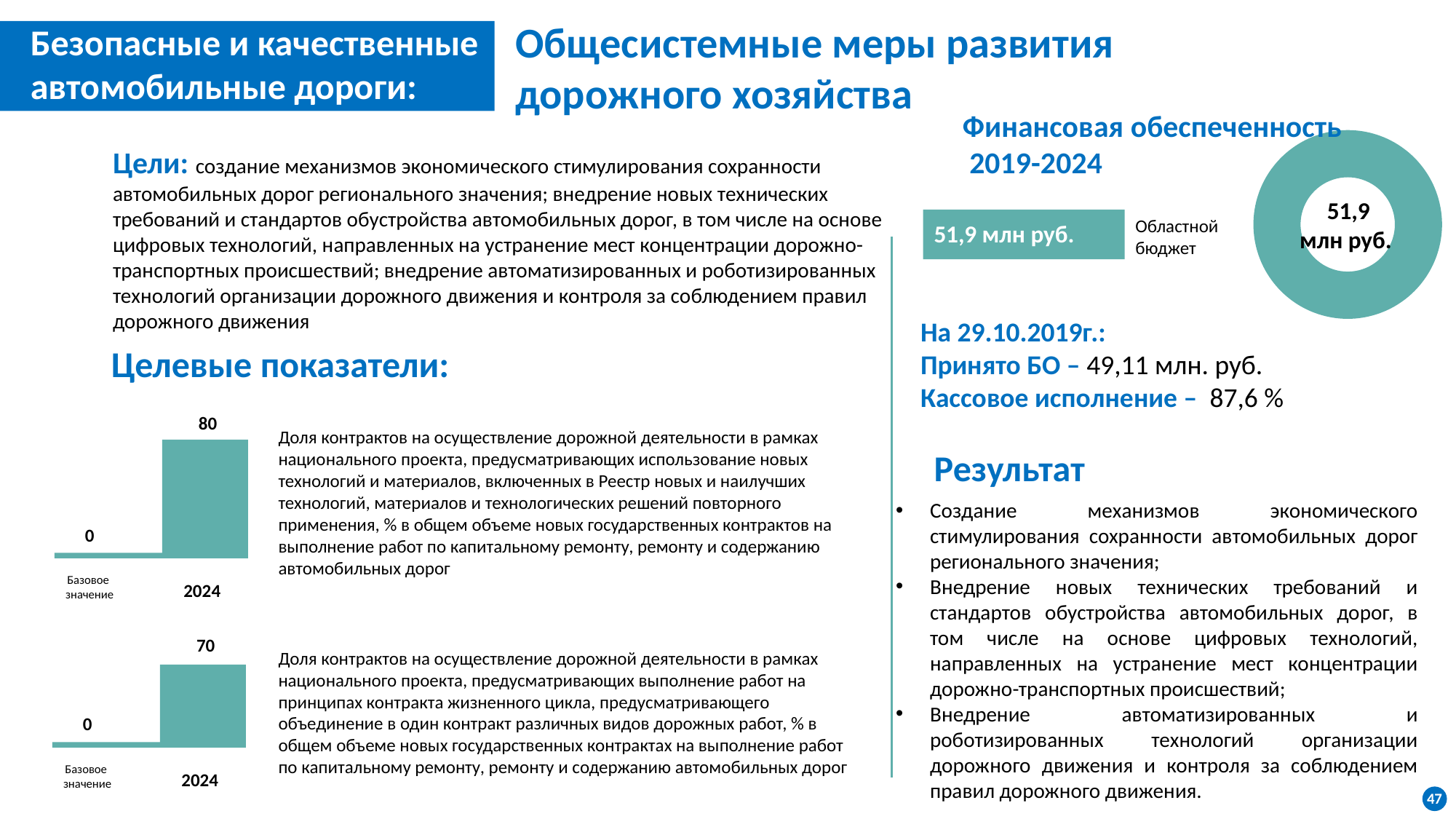
In the upper bar chart on the left, what is the value for 2024? 80 In the upper bar chart on the left, what is the value for Базовое значение? 0 In the lower bar chart on the left, which category has the lowest value? Базовое значение What value is printed in the centre of the donut chart in the top right? 51,9 млн руб. Which is larger: the 2024 value in the upper bar chart or the 2024 value in the lower bar chart? Upper bar chart (80) In the upper bar chart on the left, which category has the highest value? 2024 In the lower bar chart on the left, what is the value for 2024? 70 How many categories does the upper bar chart on the left show? 2 In the lower bar chart on the left, what is the value for Базовое значение? 0 What kind of chart is shown in the top right under Финансовая обеспеченность 2019-2024? Donut (pie) chart In the lower bar chart on the left, what is the difference between the 2024 value and the Базовое значение value? 70 In the upper bar chart on the left, what is the difference between the 2024 value and the Базовое значение value? 80